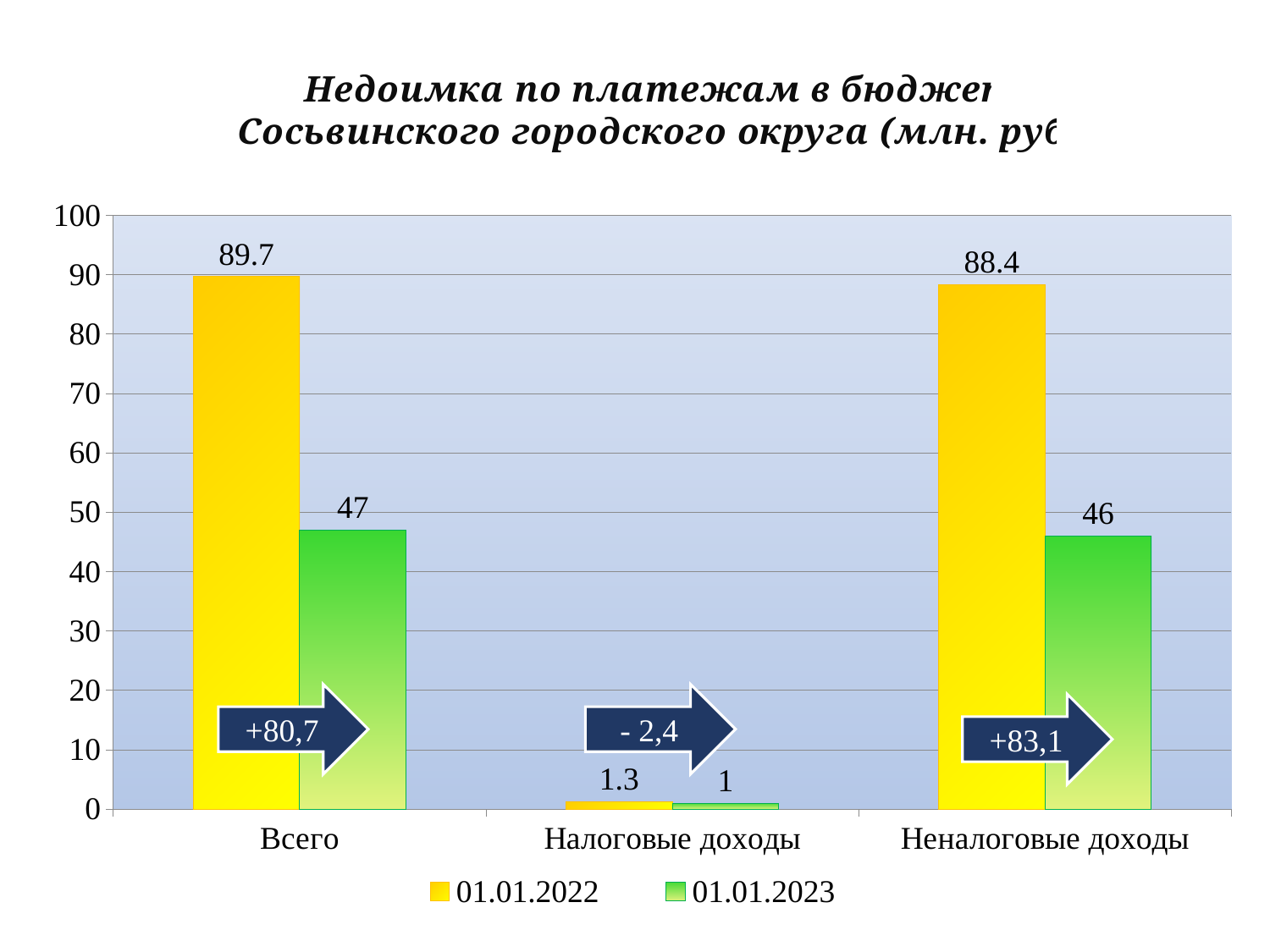
What is the value for Всего in the 01.01.2022 series? 89.7 What is the difference between the 01.01.2022 and 01.01.2023 values for Неналоговые доходы? 42.4 What kind of chart is shown on the slide? Bar chart What is the difference between the 01.01.2022 and 01.01.2023 values for Всего? 42.7 How many categories are shown on the x axis? 3 What is the value for Налоговые доходы in the 01.01.2023 series? 1 What is the value for Налоговые доходы in the 01.01.2022 series? 1.3 What is the value for Неналоговые доходы in the 01.01.2023 series? 46 Which category has the lowest value in the 01.01.2023 series? Налоговые доходы Which is larger for Неналоговые доходы: the 01.01.2022 value or the 01.01.2023 value? 01.01.2022 How many series does the legend list? 2 Which category has the highest value in the 01.01.2022 series? Всего